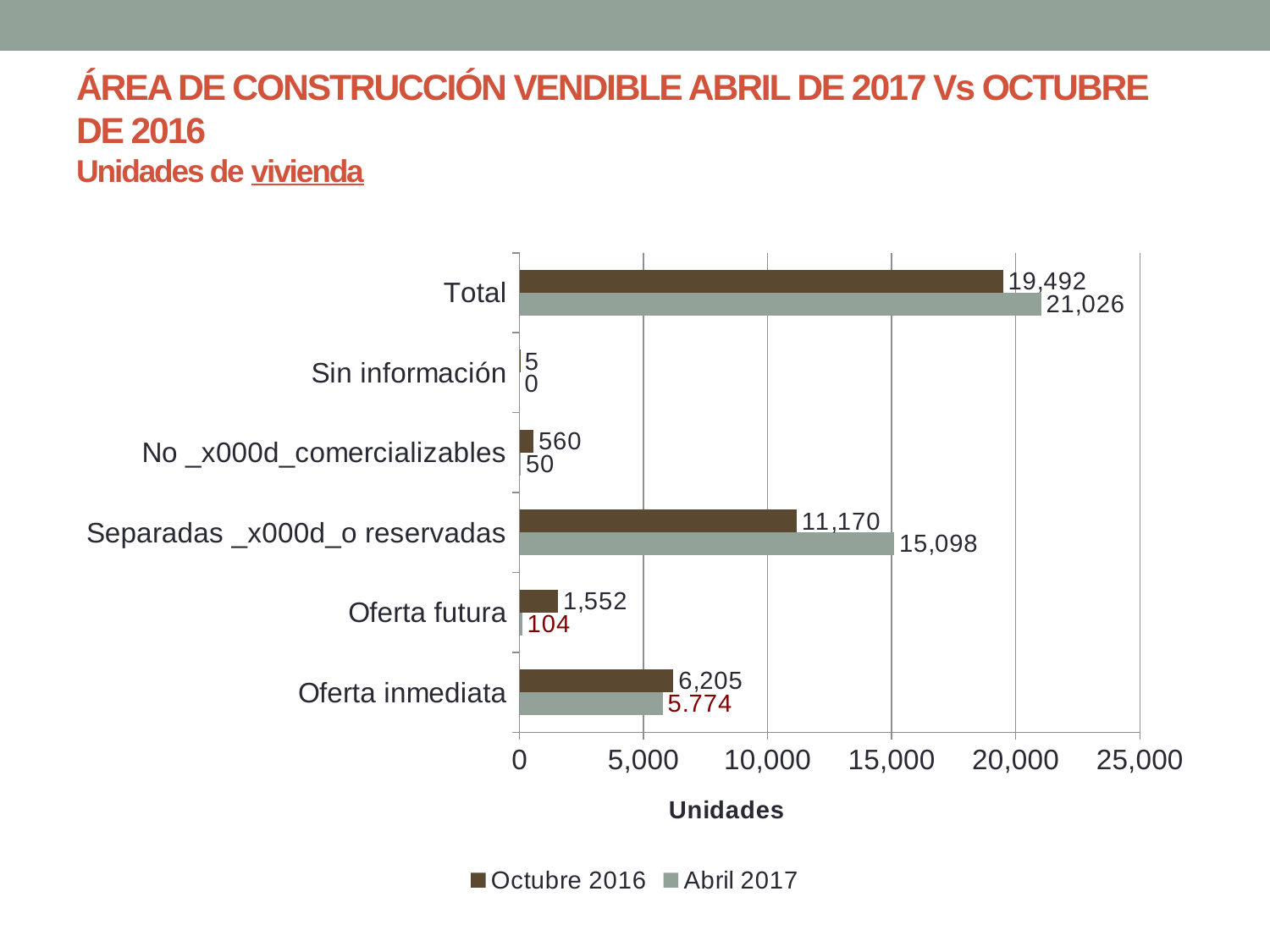
What is the value for Oferta futura in the Abril 2017 series? 104 For Oferta futura, which series has the larger value, Octubre 2016 or Abril 2017? Octubre 2016 What is the value for Separadas _x000d_o reservadas in the Octubre 2016 series? 11,170 What is the difference between the Abril 2017 and Octubre 2016 values for Separadas _x000d_o reservadas? 3,928 What kind of chart is shown on the slide? Bar chart What is the value for Oferta inmediata in the Octubre 2016 series? 6,205 How many categories are shown on the chart? 6 What is the difference between the Abril 2017 and Octubre 2016 values for Total? 1,534 What is the value for Total in the Abril 2017 series? 21,026 Which category has the lowest value in the Abril 2017 series? Sin información How many series does the legend list? 2 Excluding Total, which category has the highest value in the Abril 2017 series? Separadas _x000d_o reservadas